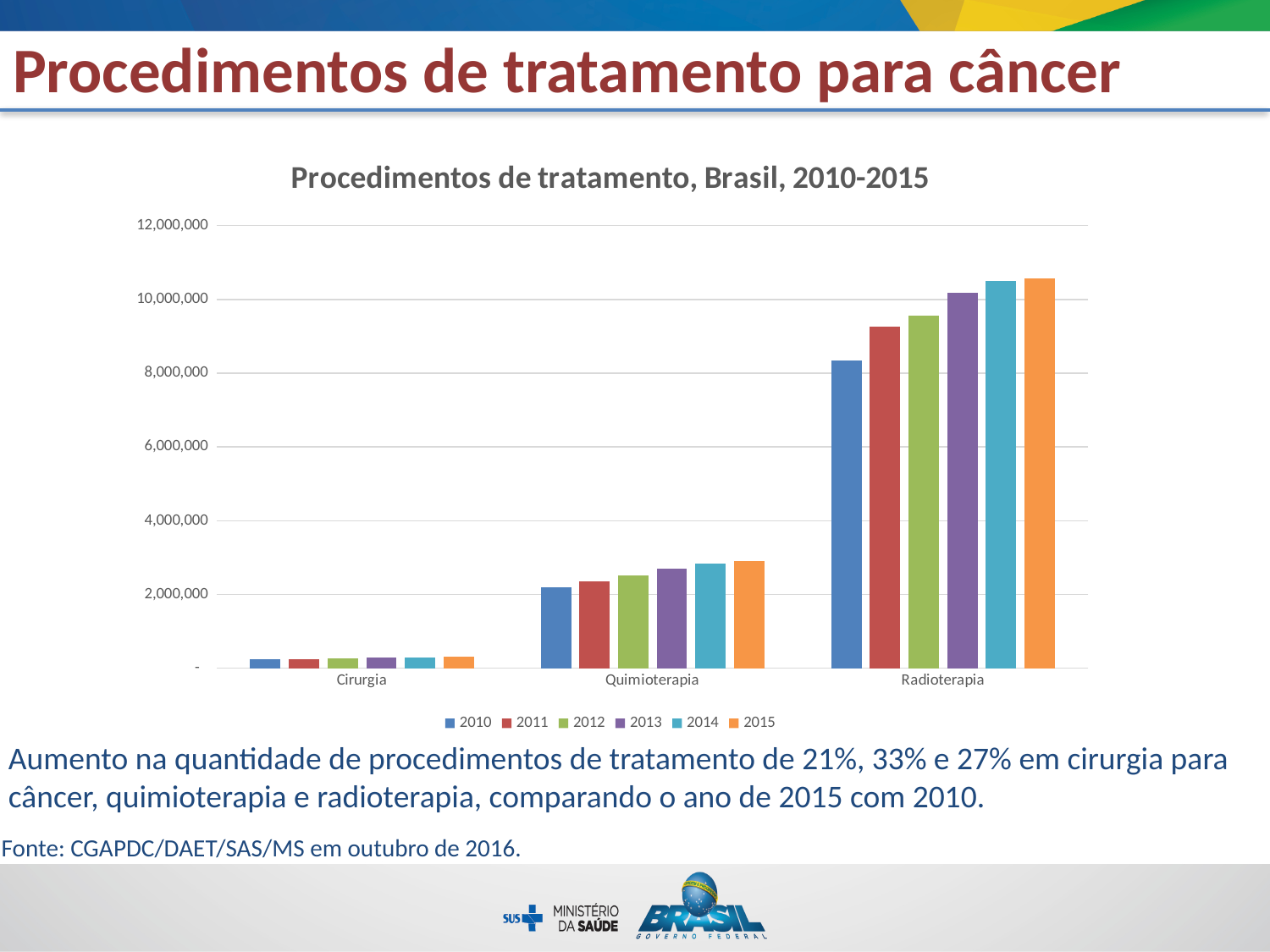
What is the title of the chart? Procedimentos de tratamento, Brasil, 2010-2015 What kind of chart is shown on the slide? bar chart Which category has the lowest values across all years? Cirurgia Which is larger in 2015, Quimioterapia or Cirurgia? Quimioterapia Is the value for Cirurgia in 2015 greater or less than 2,000,000? less Do the values for Radioterapia rise or fall from 2010 to 2015? rise Is the value for Quimioterapia in 2015 greater or less than 4,000,000? less Which category has the highest values across all years? Radioterapia Is the value for Radioterapia in 2011 greater or less than 10,000,000? less How many series does the legend list? 6 How many categories are shown on the x axis? 3